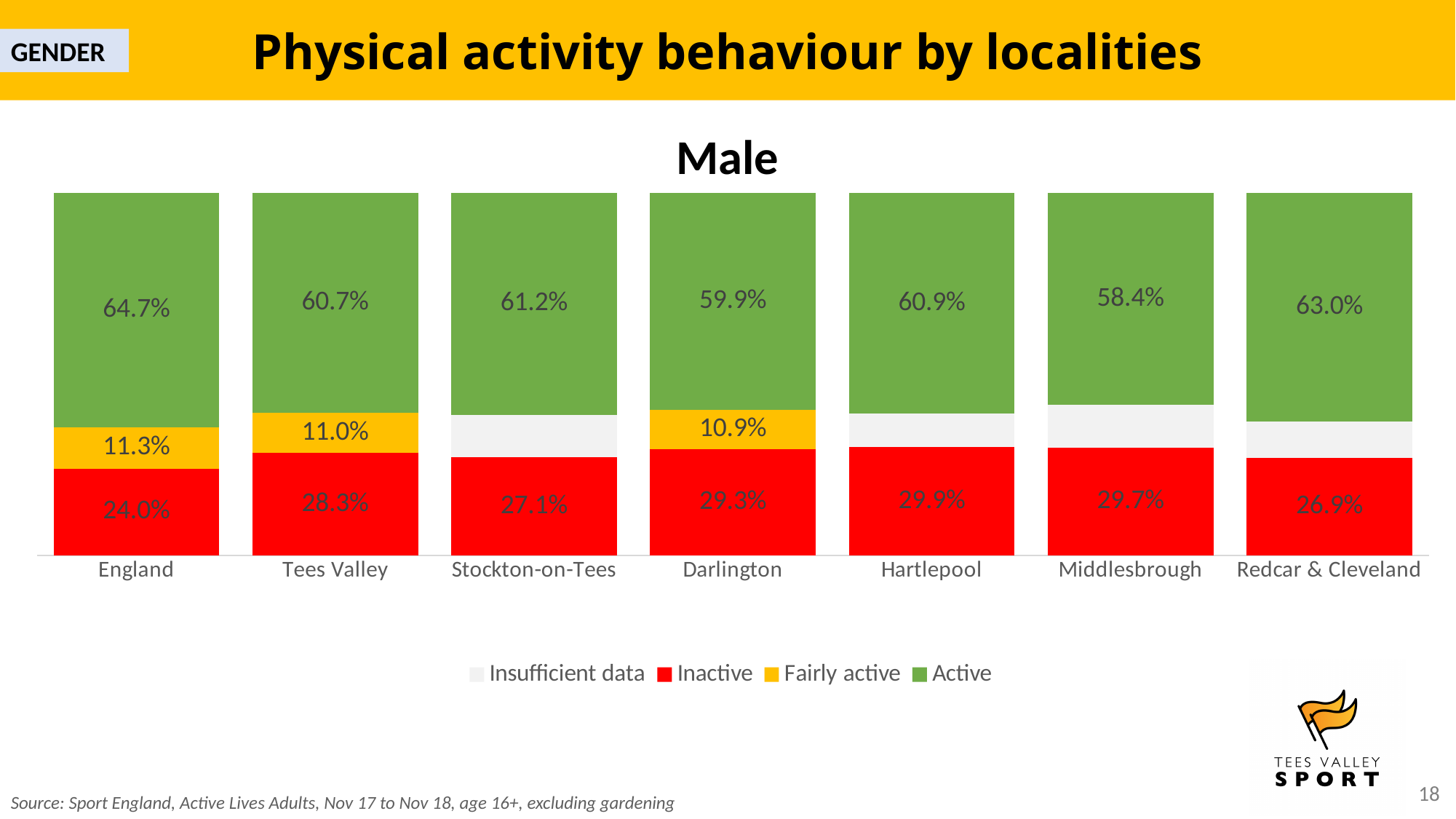
Which locality has the lowest Active percentage for males? Middlesbrough What is the difference in the Active percentage between England and Middlesbrough? 6.3 percentage points Which has a higher Inactive percentage for males, Tees Valley or Stockton-on-Tees? Tees Valley What is the Fairly active percentage for males in Tees Valley? 11.0% How many series does the legend list? 4 What kind of chart is shown on the slide? Stacked bar chart Which locality has the highest Active percentage for males? England Which locality has the lowest Inactive percentage for males? England What is the Inactive percentage for males in Darlington? 29.3% What percentage of males in England are Active? 64.7% How many localities are shown on the chart? 7 What is the total of the England stacked bar (Active, Fairly active and Inactive)? 100.0%